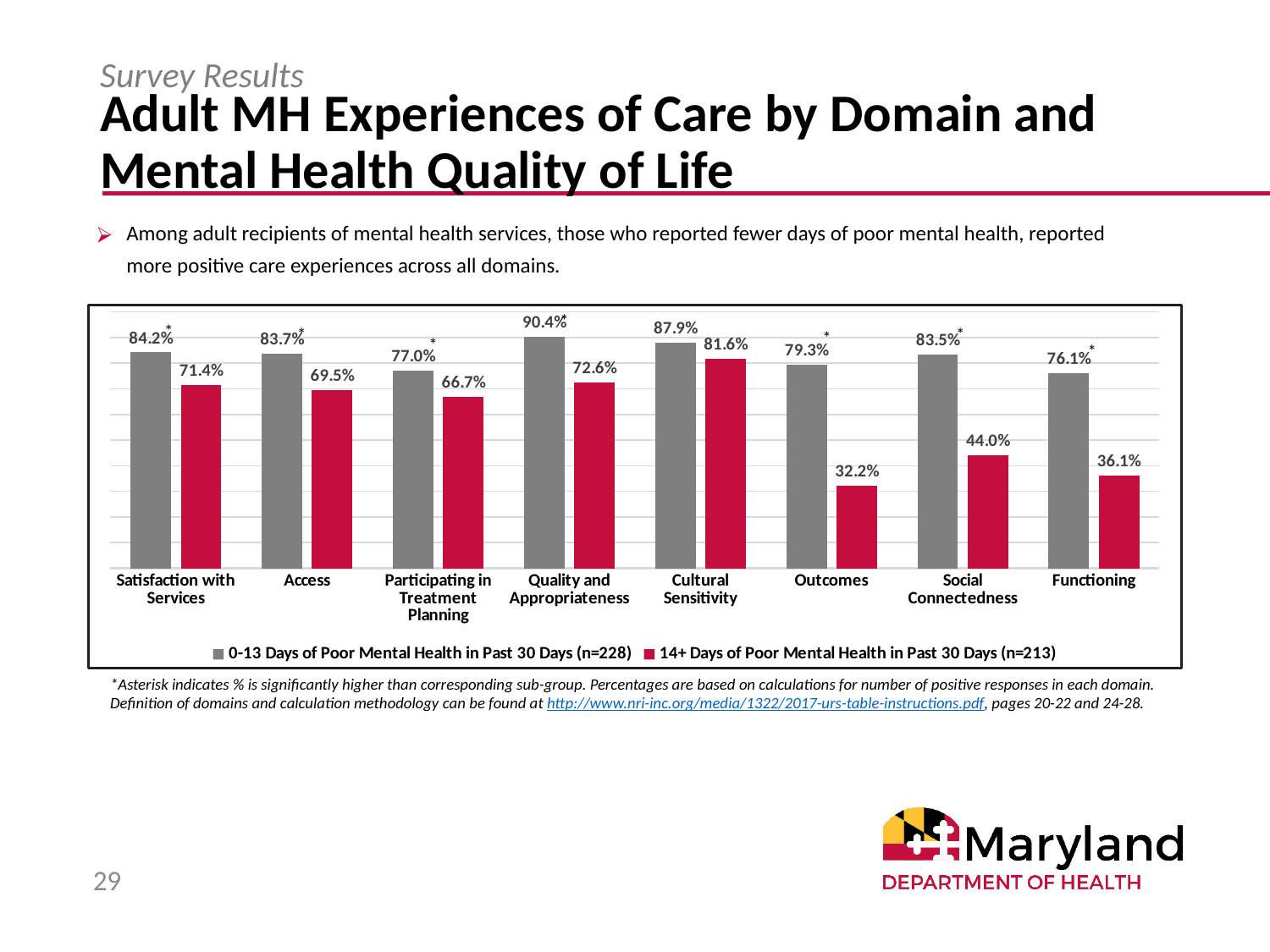
How many domains are shown on the x axis? 8 Which colour represents the 14+ Days of Poor Mental Health in Past 30 Days (n=213) series? Red What is the difference between the two series for Functioning? 40.0% Which is larger: the 14+ Days value for Cultural Sensitivity or the 14+ Days value for Quality and Appropriateness? Cultural Sensitivity What is the value for Access in the 0-13 Days of Poor Mental Health in Past 30 Days (n=228) series? 83.7% What kind of chart is shown on the slide? Bar chart Which domain has the highest value in the 0-13 Days of Poor Mental Health in Past 30 Days (n=228) series? Quality and Appropriateness What is the value for Social Connectedness in the 14+ Days of Poor Mental Health in Past 30 Days (n=213) series? 44.0% Which domain has the lowest value in the 14+ Days of Poor Mental Health in Past 30 Days (n=213) series? Outcomes What is the difference between the two series for Cultural Sensitivity? 6.3% What is the value for Outcomes in the 14+ Days of Poor Mental Health in Past 30 Days (n=213) series? 32.2% How many series does the legend list? 2